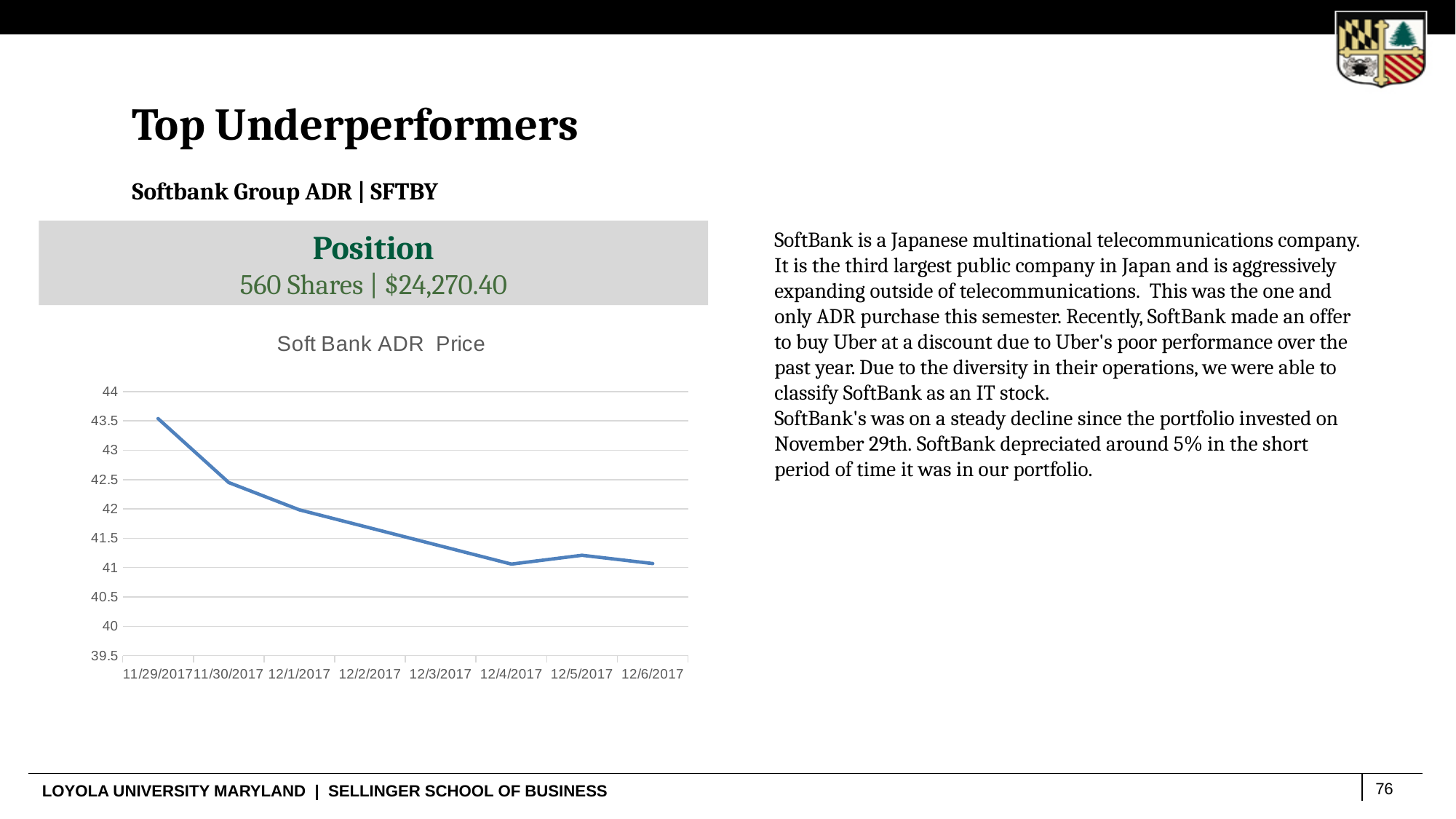
Which is larger, the value for 11/29/2017 or the value for 12/6/2017? 11/29/2017 Is the value for 11/30/2017 greater or less than 43? less What colour is the line in the chart? blue On which date is the Soft Bank ADR price highest? 11/29/2017 Is the value for 12/4/2017 greater or less than 41.5? less How many dates are plotted along the x axis of the chart? 8 Does the Soft Bank ADR price generally rise or fall from 11/29/2017 to 12/6/2017? fall What kind of chart is shown on the slide? line chart What is the title of the chart? Soft Bank ADR Price Is the value for 11/29/2017 greater or less than 43? greater